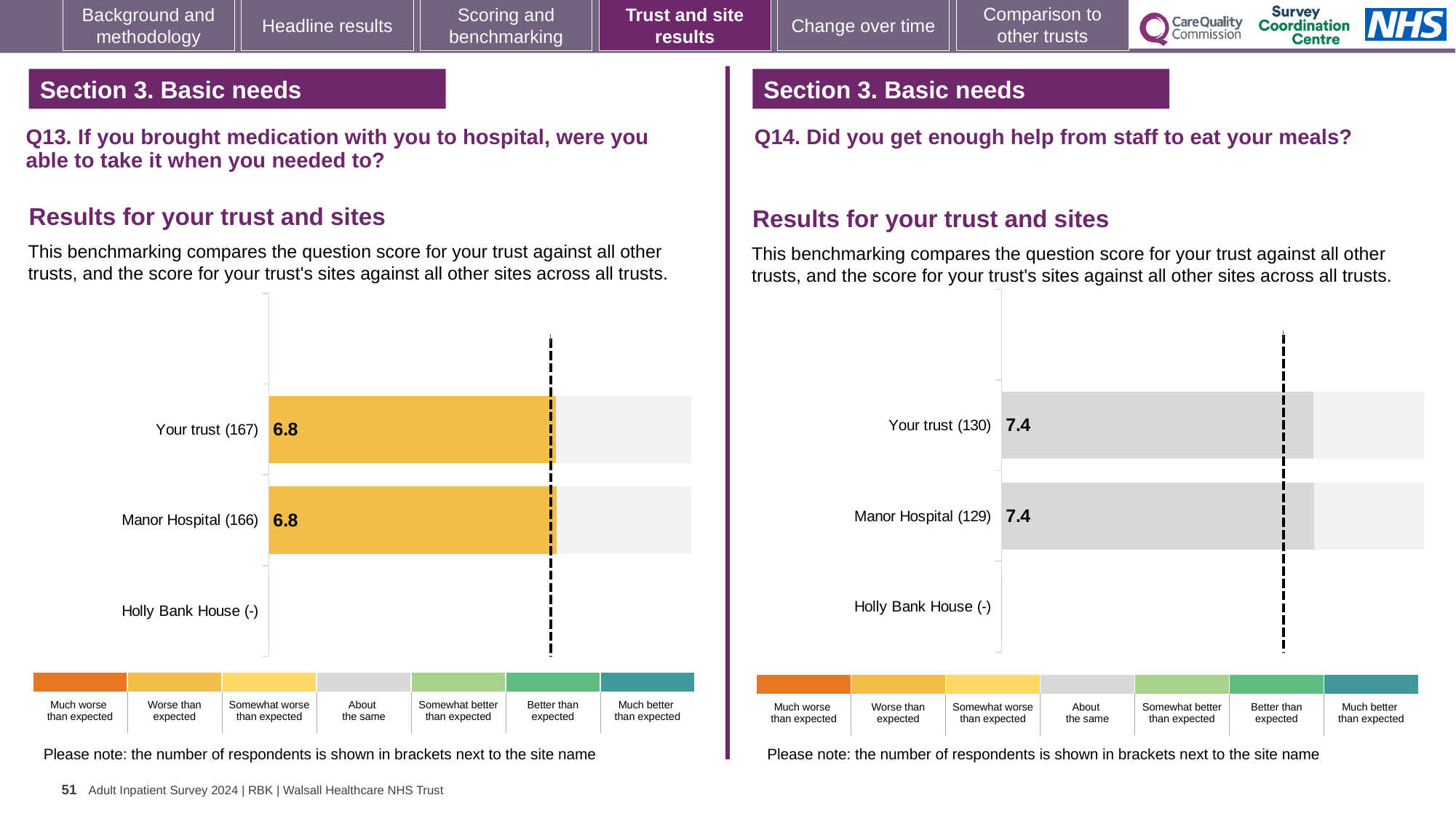
On the Q14 chart (right), what is the score for Manor Hospital? 7.4 On the Q13 chart (left), what is the difference between the scores for Your trust and Manor Hospital? 0.0 On the Q13 chart (left), what is the score for Your trust? 6.8 How many categories (rows) are listed on the Q13 chart (left)? 3 What kind of chart is the Q13 chart (left)? Bar chart On the Q14 chart (right), what is the difference between the scores for Your trust and Manor Hospital? 0.0 On the Q14 chart (right), how many respondents are shown in brackets for Manor Hospital? 129 How many categories (rows) are listed on the Q14 chart (right)? 3 On the Q13 chart (left), how many respondents are shown in brackets for Your trust? 167 On the Q13 chart (left), what is the score for Manor Hospital? 6.8 Which site on the Q14 chart (right) has no score shown? Holly Bank House On the Q14 chart (right), what is the score for Your trust? 7.4